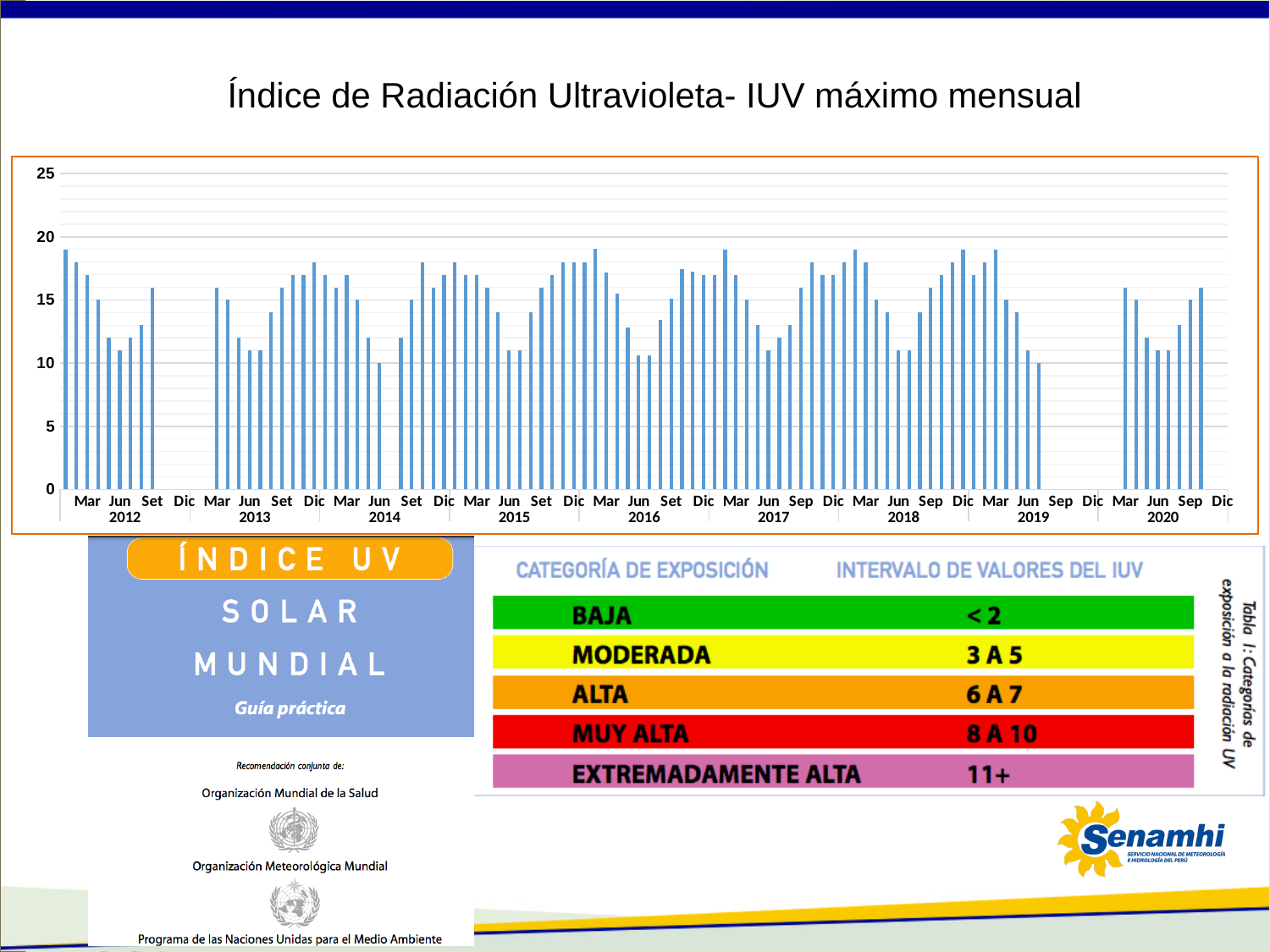
What kind of chart is shown on the slide? bar chart What is the title of the chart? Índice de Radiación Ultravioleta- IUV máximo mensual Is the value for Jun 2018 greater or less than 15? less Is the value for Mar 2016 greater or less than 15? greater Is the value for Mar 2019 greater or less than 15? greater How many years are labelled along the x axis of the chart? 9 What is the highest value shown on the y axis of the chart? 25